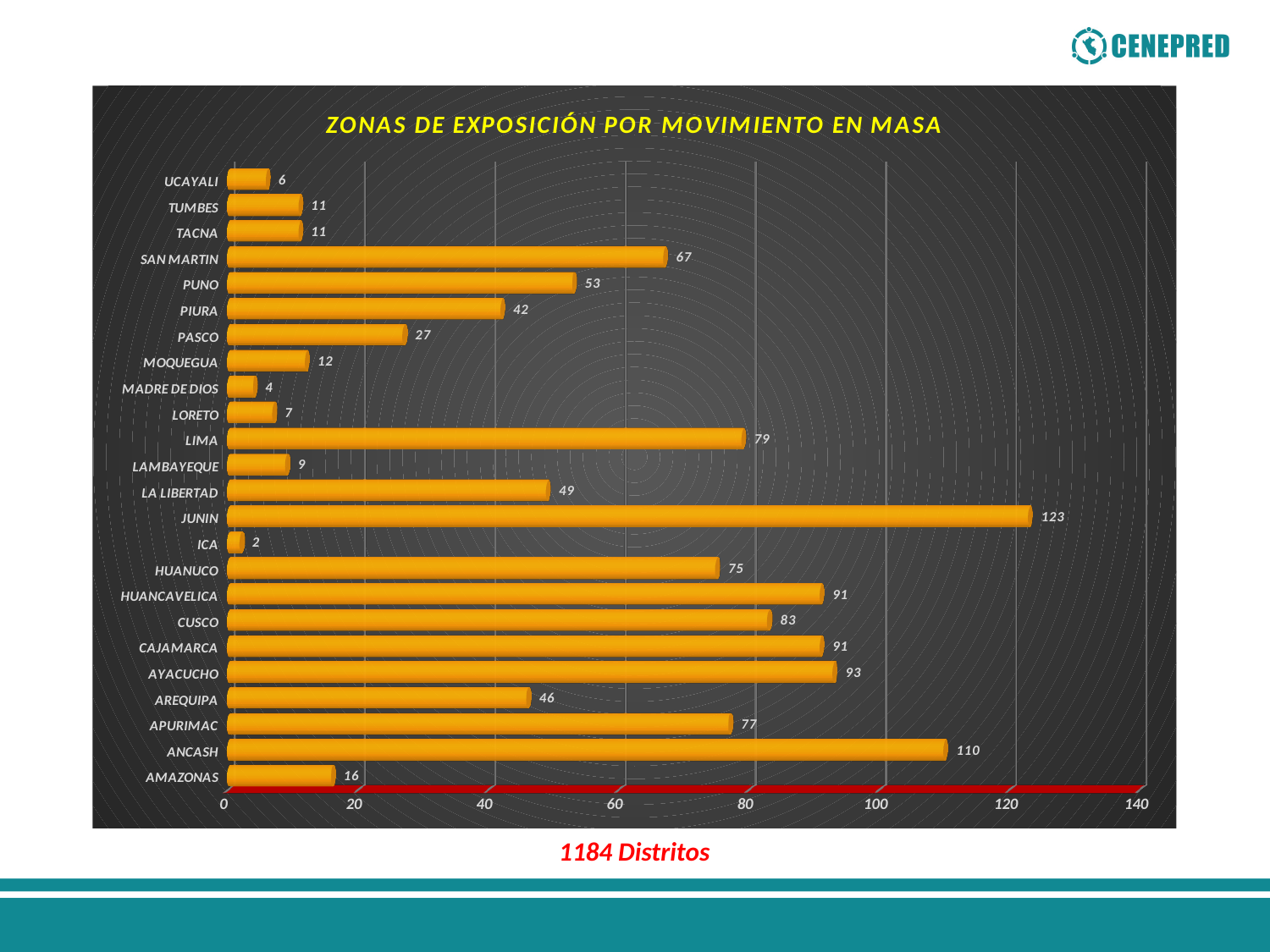
Which region has the highest value? JUNIN What is the value for MADRE DE DIOS? 4 What is the difference between the values for SAN MARTIN and PUNO? 14 What is the value for ANCASH? 110 What kind of chart is this? bar chart What is the value for JUNIN? 123 Is the value for AYACUCHO greater or less than 80? greater How many regions are shown in the chart? 24 Which has a larger value, LIMA or CUSCO? CUSCO Which region has the lowest value? ICA What is the difference between the values for JUNIN and ANCASH? 13 What is the title of the chart? ZONAS DE EXPOSICIÓN POR MOVIMIENTO EN MASA